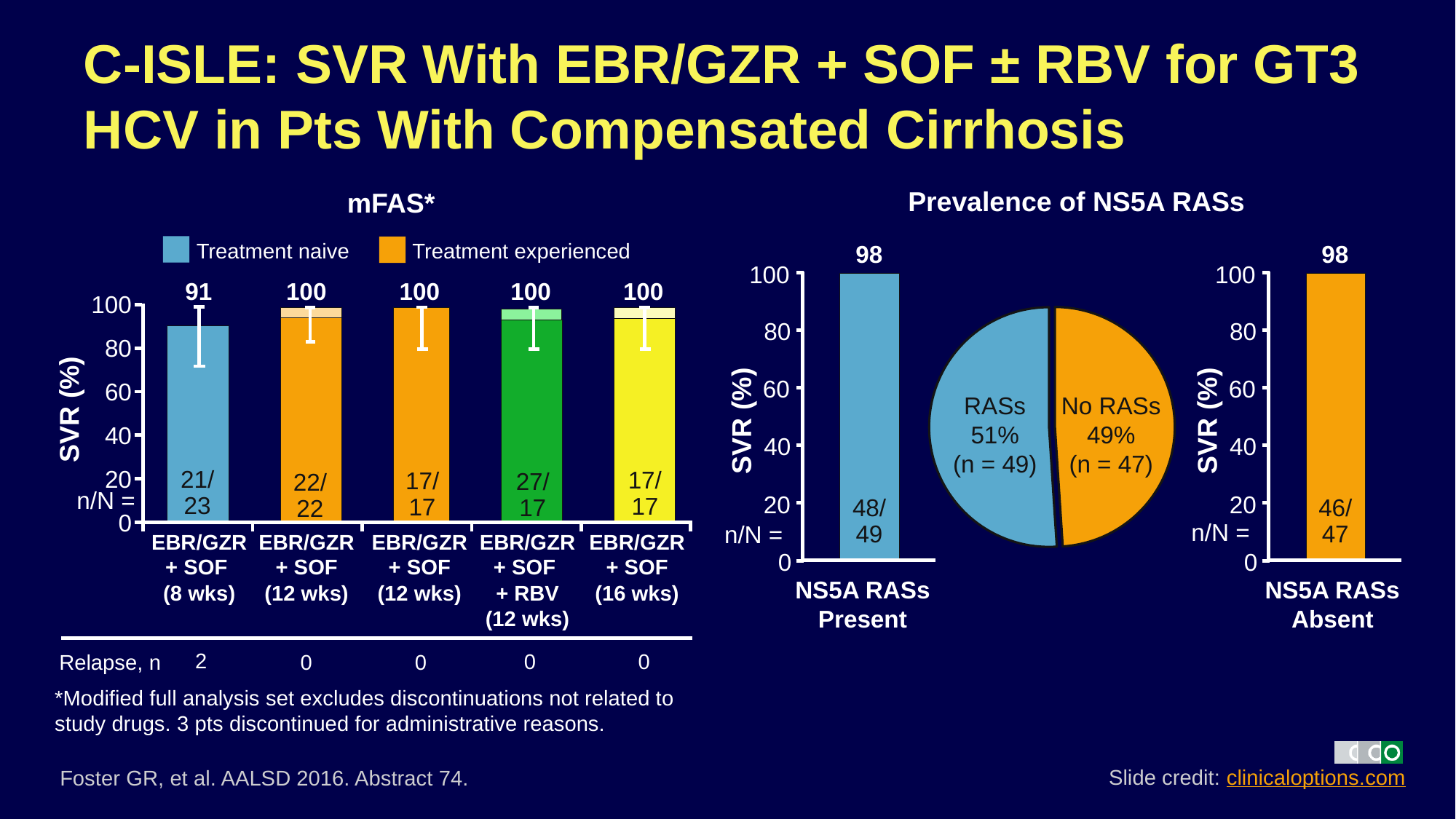
In the mFAS chart, which regimen has the lowest SVR (%)? EBR/GZR + SOF (8 wks) In the mFAS chart, how many relapses are reported for EBR/GZR + SOF (8 wks)? 2 In the mFAS chart, how many bars are plotted? 5 In the Prevalence of NS5A RASs pie chart, how many patients had no RASs? 47 In the mFAS chart, what is the SVR (%) for EBR/GZR + SOF (8 wks)? 91 In the NS5A RASs Present bar chart, what is the SVR (%)? 98 In the mFAS chart, how many series does the legend list? 2 What kind of chart is the mFAS chart? Bar chart In the mFAS chart, what is the n/N shown for the EBR/GZR + SOF + RBV (12 wks) bar? 27/17 In the NS5A RASs Absent bar chart, what is the n/N shown on the bar? 46/47 In the Prevalence of NS5A RASs pie chart, what share of patients had RASs? 51% In the mFAS chart, what is the difference in SVR (%) between EBR/GZR + SOF (12 wks) and EBR/GZR + SOF (8 wks)? 9